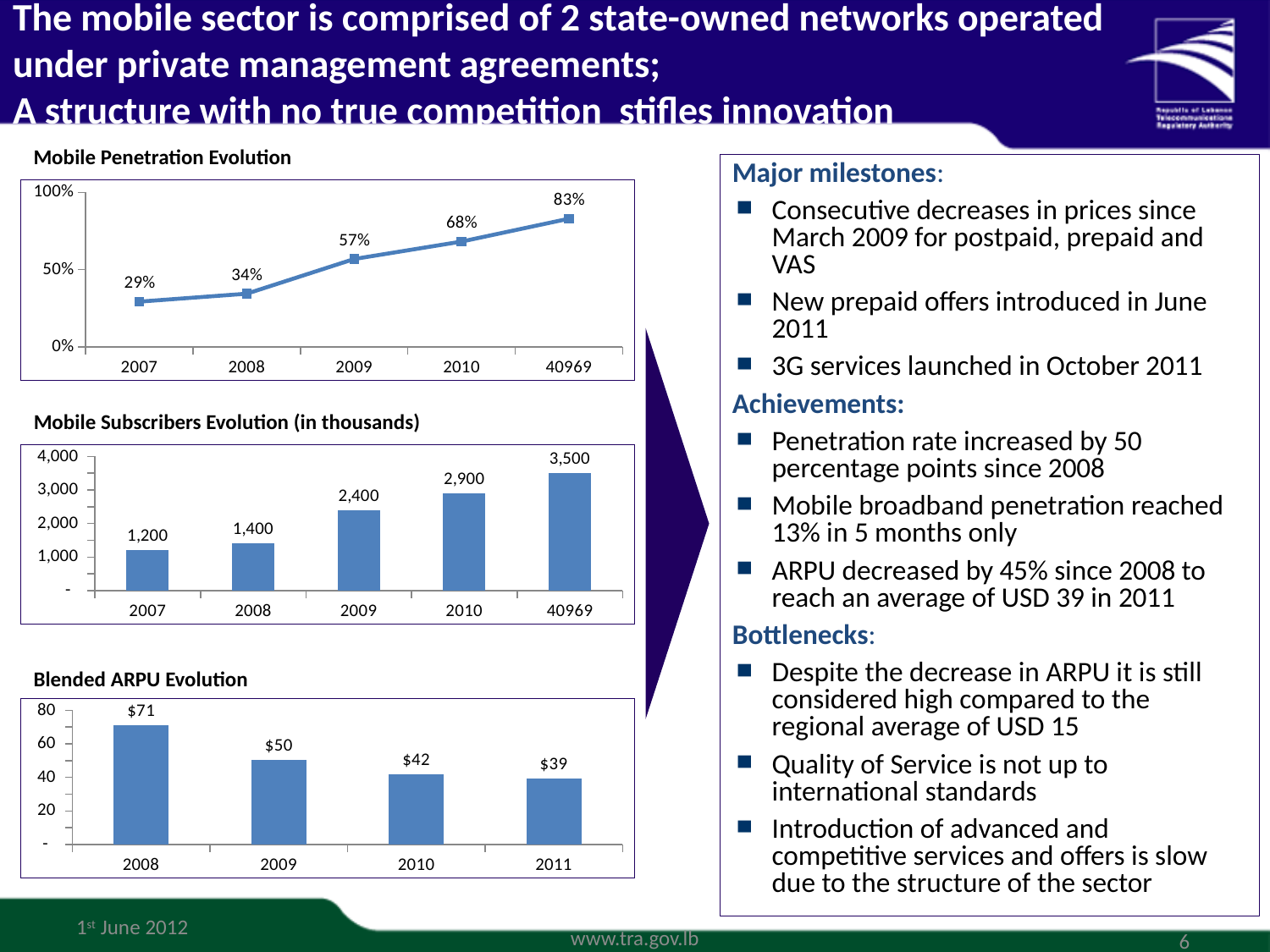
In the Mobile Penetration Evolution chart, what is the penetration rate for 2007? 29% In the Blended ARPU Evolution chart, which year has the lowest ARPU? 2011 In the Mobile Subscribers Evolution chart, what is the value for 2009? 2,400 In the Blended ARPU Evolution chart, is the value for 2009 larger or smaller than the value for 2010? Larger In the Mobile Subscribers Evolution chart, which year has the lowest number of subscribers? 2007 In the Mobile Penetration Evolution chart, what is the difference in penetration between 2010 and 2008? 34% What kind of chart is the Mobile Penetration Evolution chart? Line chart In the Mobile Subscribers Evolution chart, what is the difference between the 2010 and 2007 values? 1,700 In the Mobile Penetration Evolution chart, what is the penetration rate for 2009? 57% In the Mobile Penetration Evolution chart, do the values rise or fall from 2007 onward along the x axis? Rise How many bars are plotted in the Mobile Subscribers Evolution chart? 5 In the Blended ARPU Evolution chart, what is the value for 2008? $71